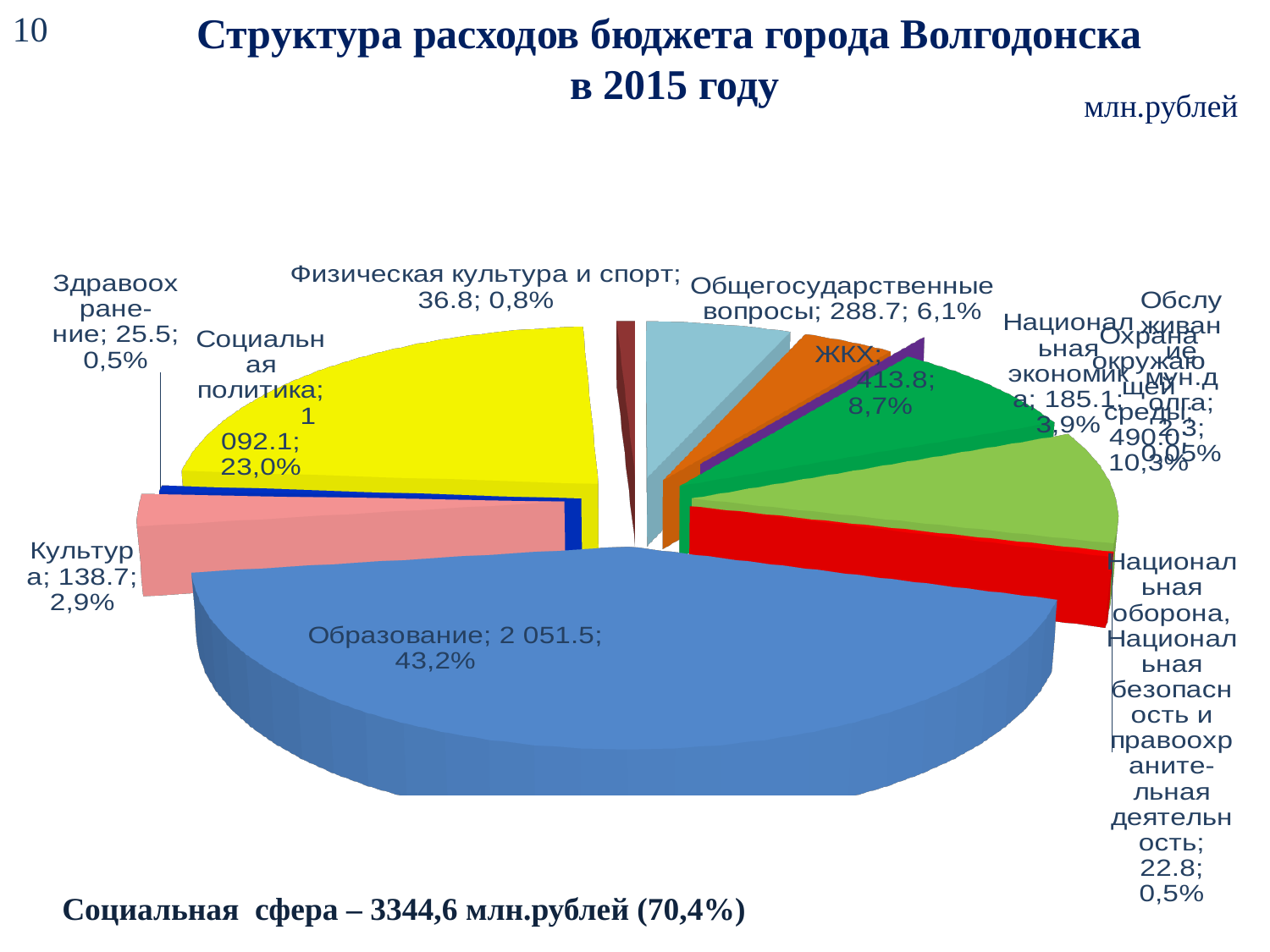
Which category has the largest slice of the pie? Образование Which is larger, the value for Культура or the value for Здравоохранение? Культура What share of the pie does Образование take? 43,2% What kind of chart is shown on the slide? pie chart What share of the pie does ЖКХ take? 8,7% What is the value for Социальная политика? 1 092.1 What is the value for Образование? 2 051.5 What is the title of the chart? Структура расходов бюджета города Волгодонска в 2015 году What is the value for Физическая культура и спорт? 36.8 What is the difference between the values for Общегосударственные вопросы and Национальная экономика? 103.6 What is the difference between the values for Образование and Социальная политика? 959.4 In what units are the chart values given? млн.рублей